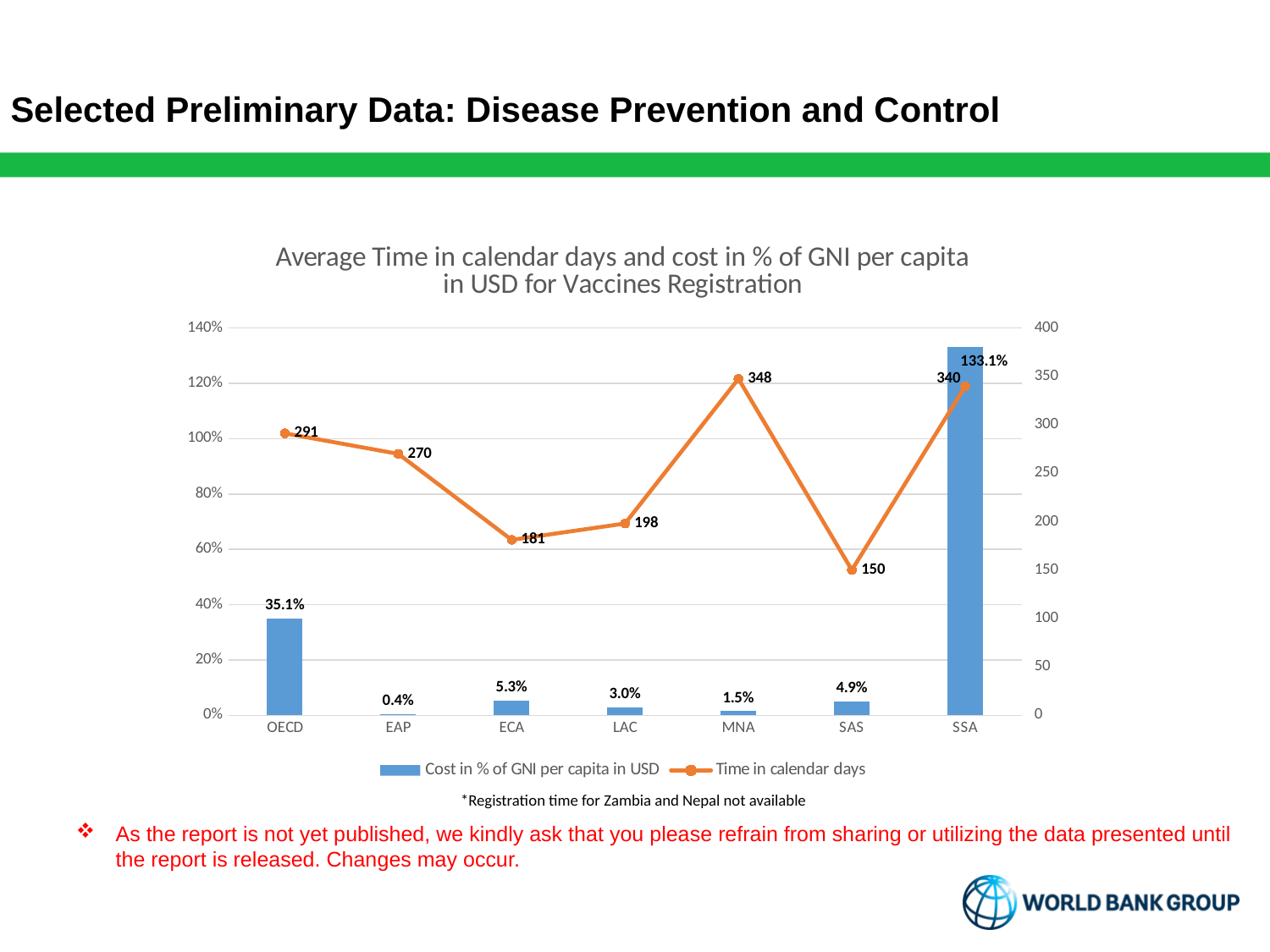
What kind of chart is used to show the cost in % of GNI per capita? Bar chart How many series does the legend list? 2 How many regions are shown on the x axis? 7 What is the difference in time in calendar days between MNA and SAS? 198 What is the cost in % of GNI per capita for OECD? 35.1% Which region has the highest cost in % of GNI per capita? SSA Which region has the lowest cost in % of GNI per capita? EAP What is the time in calendar days for MNA? 348 Which has a higher time in calendar days, OECD or ECA? OECD What is the time in calendar days for LAC? 198 Which region has the lowest time in calendar days? SAS What is the cost in % of GNI per capita for SSA? 133.1%